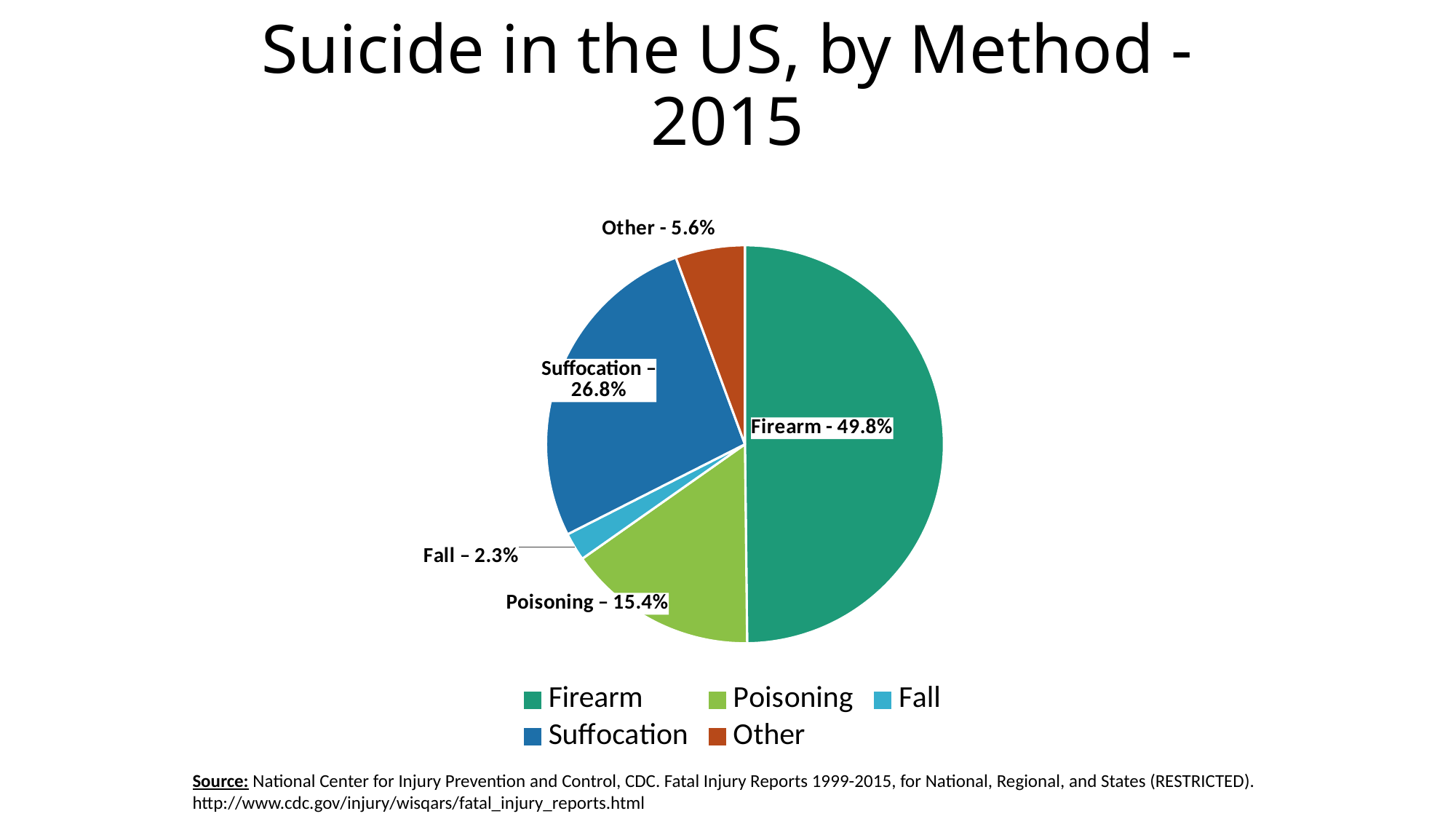
Which is larger, the Poisoning slice or the Other slice? Poisoning What is the value shown for Poisoning? 15.4% How many percentage points larger is the Firearm share than the Suffocation share? 23 percentage points What share of suicides in the US in 2015 was by firearm? 49.8% What is the title of the chart? Suicide in the US, by Method - 2015 How many slices does the pie chart have? 5 What is the value shown for Fall? 2.3% What is the value shown for the Other slice? 5.6% Which method accounts for the largest slice of the pie? Firearm What percentage of the pie is labelled Suffocation? 26.8% Which method accounts for the smallest slice of the pie? Fall What kind of chart is shown on the slide? pie chart